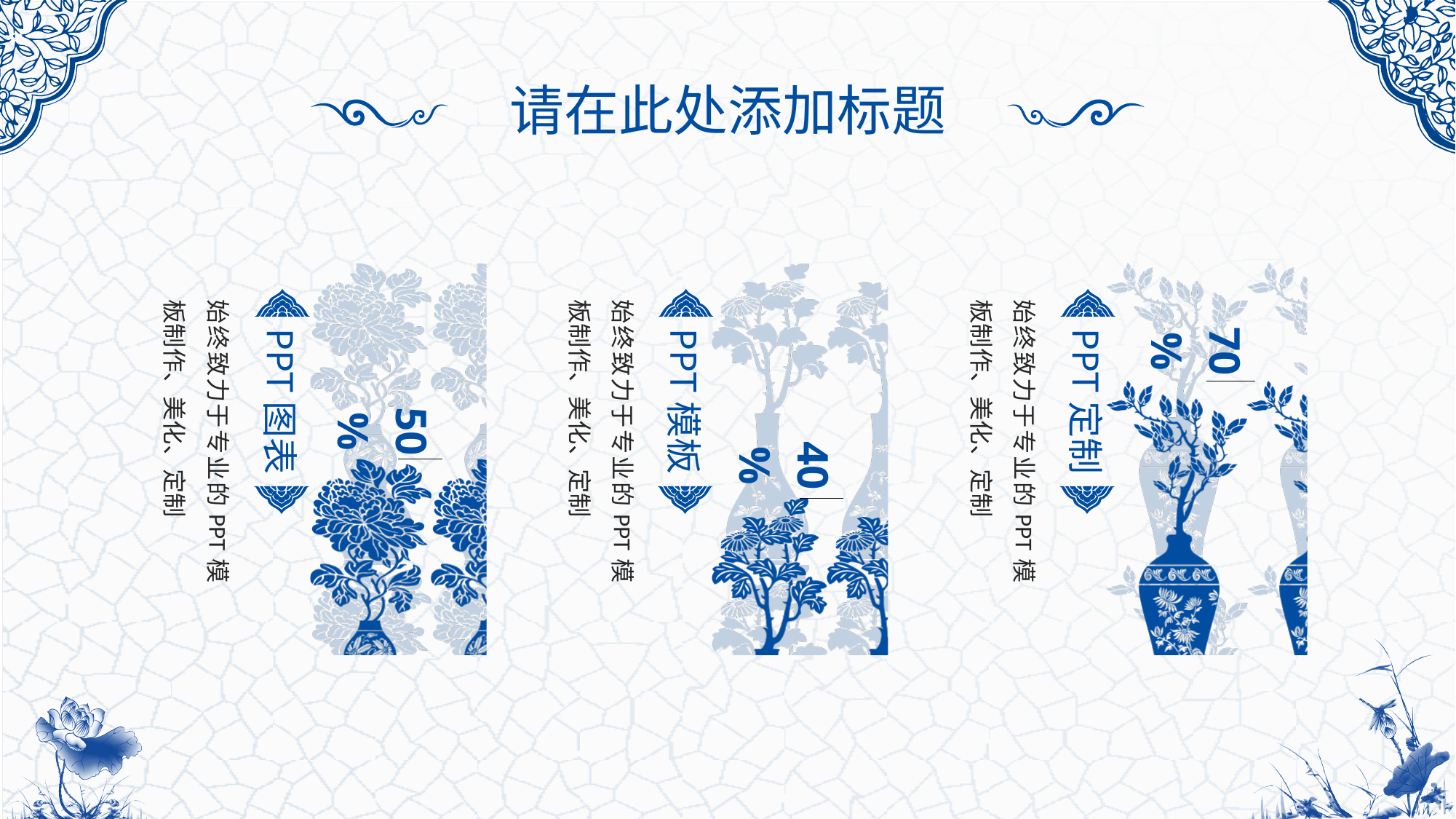
What is the title of the slide? 请在此处添加标题 What is the difference between the percentages for PPT 图表 and PPT 模板? 10% Which item has the lowest percentage? PPT 模板 What percentage is shown for PPT 模板? 40% What kind of chart is used to show the percentages? Pictorial fill chart (vase-shaped infographic) Which is larger, the percentage for PPT 图表 or for PPT 定制? PPT 定制 How many items with percentages are shown on the slide? 3 What is the difference between the percentages for PPT 定制 and PPT 模板? 30% Which item has the highest percentage? PPT 定制 What colour are the filled portions of the vase graphics? Blue What percentage is shown for PPT 定制? 70% What percentage is shown for PPT 图表? 50%